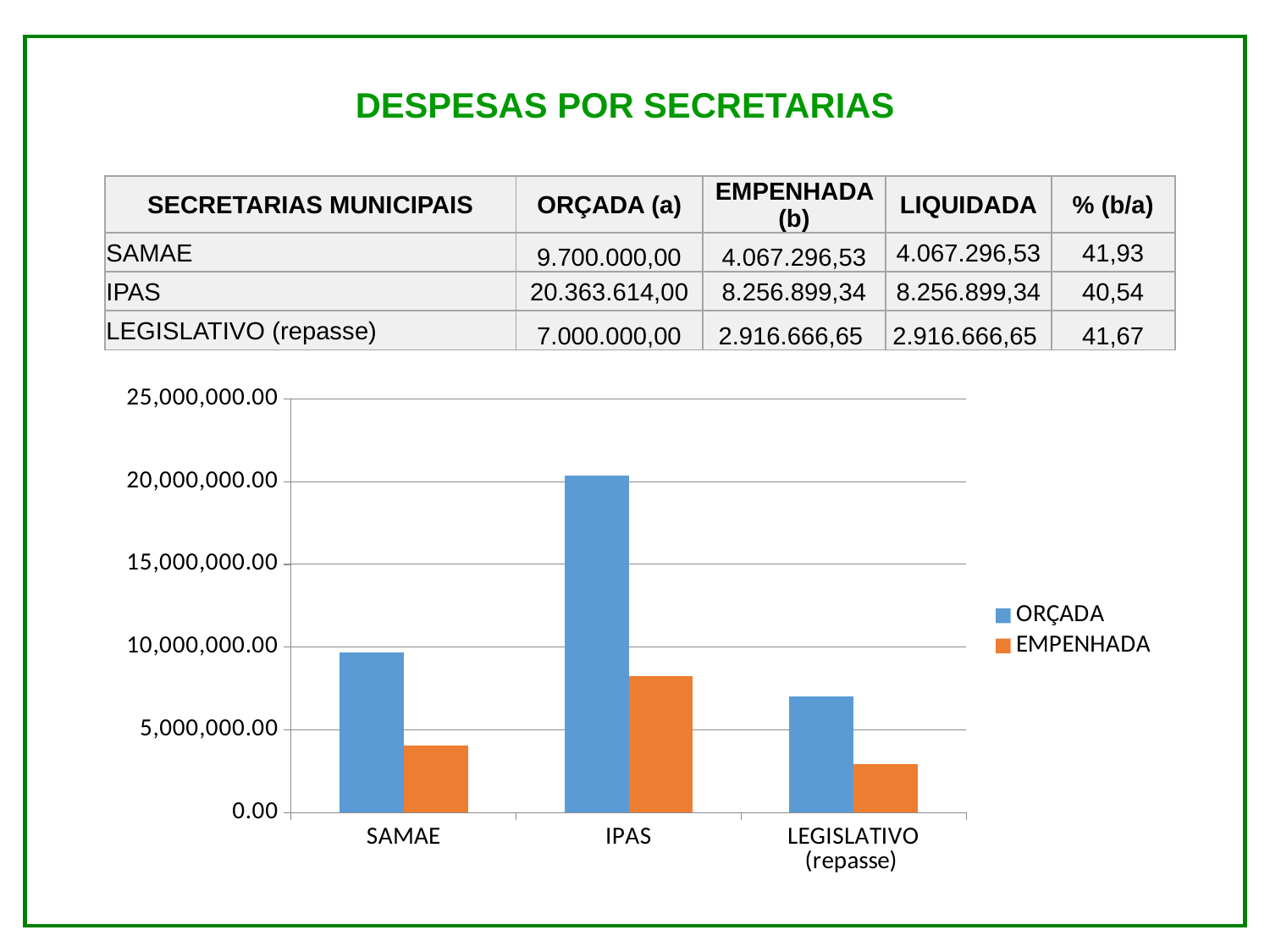
According to the slide, what is the ORÇADA value for IPAS? 20.363.614,00 According to the slide, what is the EMPENHADA value for LEGISLATIVO (repasse)? 2.916.666,65 Is the ORÇADA value for IPAS greater or less than 20,000,000.00? greater What kind of chart is shown on the slide? bar chart Which is larger, the ORÇADA bar for SAMAE or the ORÇADA bar for LEGISLATIVO (repasse)? SAMAE Which category has the highest ORÇADA bar in the chart? IPAS Which category has the lowest EMPENHADA bar in the chart? LEGISLATIVO (repasse) Is the EMPENHADA value for SAMAE greater or less than 5,000,000.00? less Which colour represents the EMPENHADA series in the chart? orange How many categories are shown on the x axis of the chart? 3 How many series does the chart legend list? 2 Is the ORÇADA value for SAMAE greater or less than 10,000,000.00? less